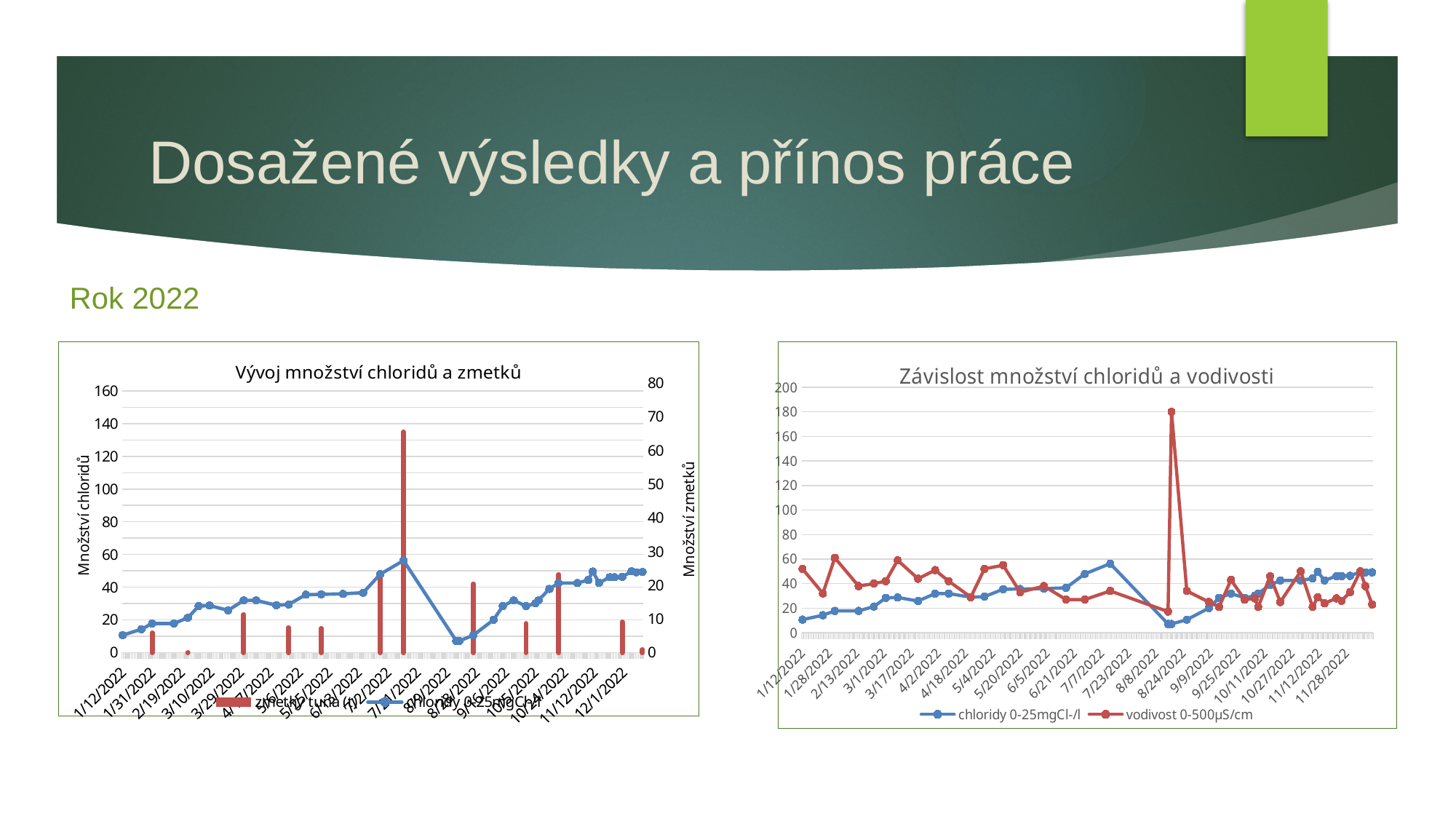
How many series does the legend of the right-hand chart 'Závislost množství chloridů a vodivosti' list? 2 In the left-hand chart 'Vývoj množství chloridů a zmetků', is the chloridy line value at 8/9/2022 greater or less than 20? less What is the highest tick on the left y axis (Množství chloridů) of the left-hand chart 'Vývoj množství chloridů a zmetků'? 160 In the left-hand chart 'Vývoj množství chloridů a zmetků', is the tallest bar greater or less than 60 on the right-hand axis (Množství zmetků)? greater In the right-hand chart 'Závislost množství chloridů a vodivosti', which series reaches the highest single value? vodivost 0-500µS/cm In the right-hand chart 'Závislost množství chloridů a vodivosti', is the peak value of the vodivost series greater or less than 160? greater What is the title of the left-hand chart? Vývoj množství chloridů a zmetků In the right-hand chart 'Závislost množství chloridů a vodivosti', does the chloridy series generally rise or fall between 1/12/2022 and 7/7/2022? rise What is the highest tick shown on the y axis of the right-hand chart 'Závislost množství chloridů a vodivosti'? 200 What kind of chart is the right-hand chart, 'Závislost množství chloridů a vodivosti'? line chart What kind of chart is the left-hand chart 'Vývoj množství chloridů a zmetků'? combined bar and line chart